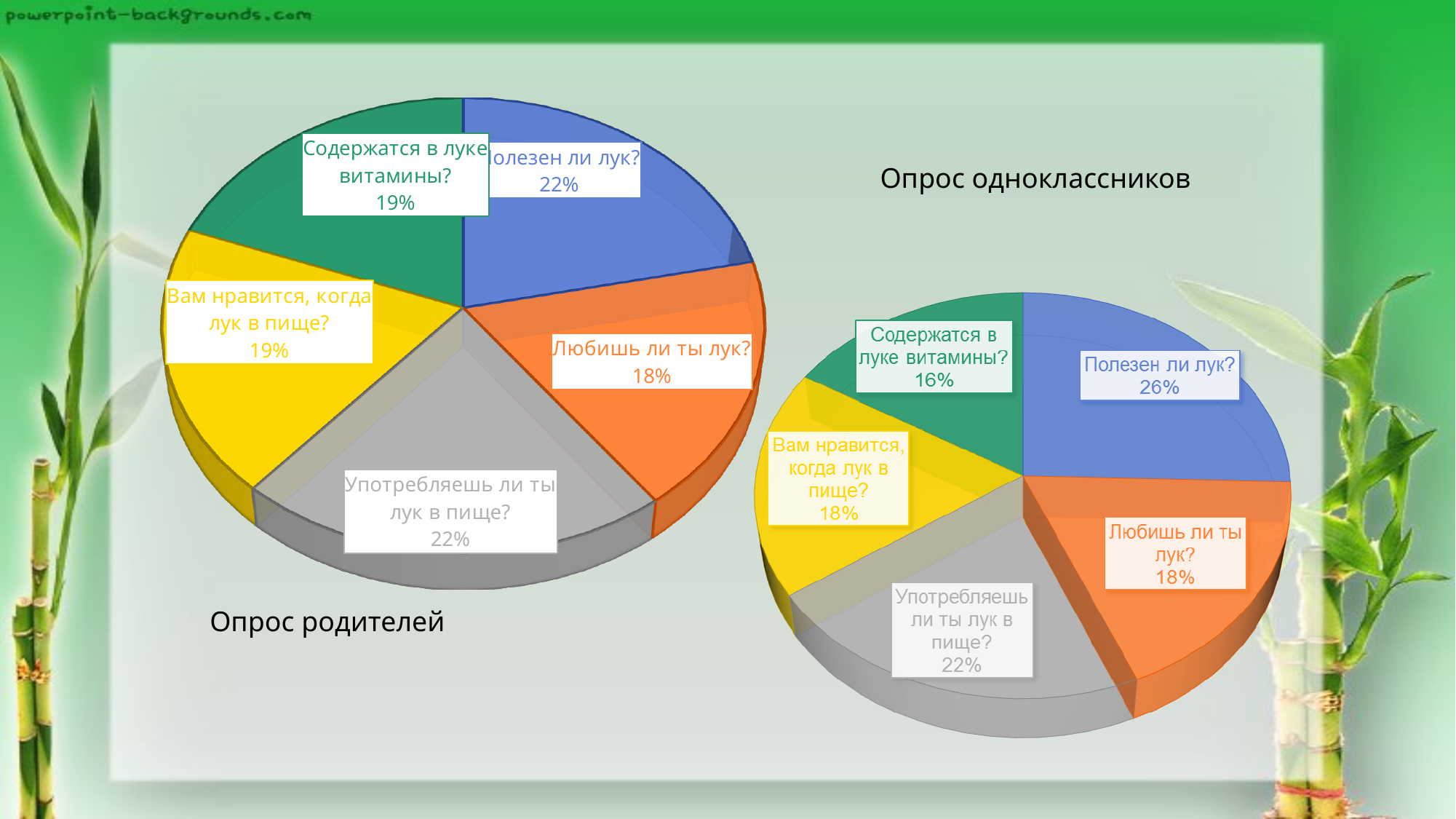
In the "Опрос одноклассников" chart, what is the difference between "Полезен ли лук?" and "Употребляешь ли ты лук в пище?"? 4% What type of chart is "Опрос одноклассников"? Pie chart In the "Опрос родителей" chart, which is larger: "Полезен ли лук?" or "Содержатся в луке витамины?"? Полезен ли лук? In the "Опрос одноклассников" chart, what percentage is shown for "Содержатся в луке витамины?"? 16% In the "Опрос одноклассников" chart, which slice is the largest? Полезен ли лук? In the "Опрос родителей" chart, what percentage is shown for "Полезен ли лук?"? 22% In the "Опрос родителей" chart, what percentage is shown for "Любишь ли ты лук?"? 18% How many slices does the "Опрос родителей" chart have? 5 In the "Опрос одноклассников" chart, what percentage is shown for "Полезен ли лук?"? 26% What is the title of the chart on the left side of the slide? Опрос родителей In the "Опрос родителей" chart, which slice is the smallest? Любишь ли ты лук? In the "Опрос одноклассников" chart, which slice is the smallest? Содержатся в луке витамины?